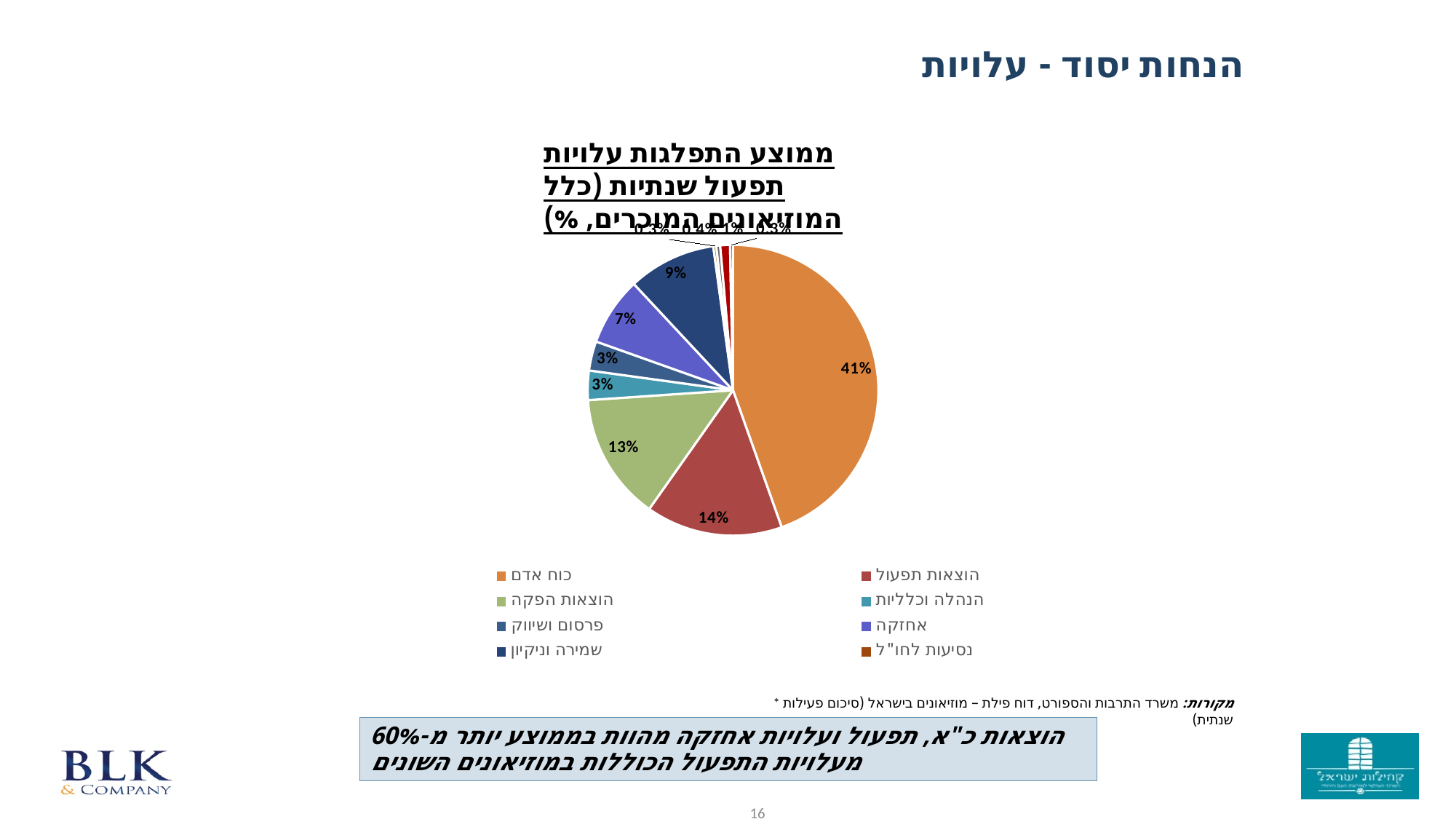
How many entries does the legend list? 8 What share of the pie does כוח אדם account for? 41% What is the value shown for שמירה וניקיון? 9% What is the combined share of כוח אדם, הוצאות תפעול and הוצאות הפקה? 68% What is the value shown for הוצאות הפקה? 13% What colour is the slice for כוח אדם? Orange What is the value shown for הוצאות תפעול? 14% What kind of chart is shown on the slide? Pie chart What is the value shown for אחזקה? 7% Which is larger, הוצאות תפעול or הוצאות הפקה? הוצאות תפעול What is the difference in percentage points between כוח אדם and הוצאות תפעול? 27 Which category has the largest slice of the pie? כוח אדם